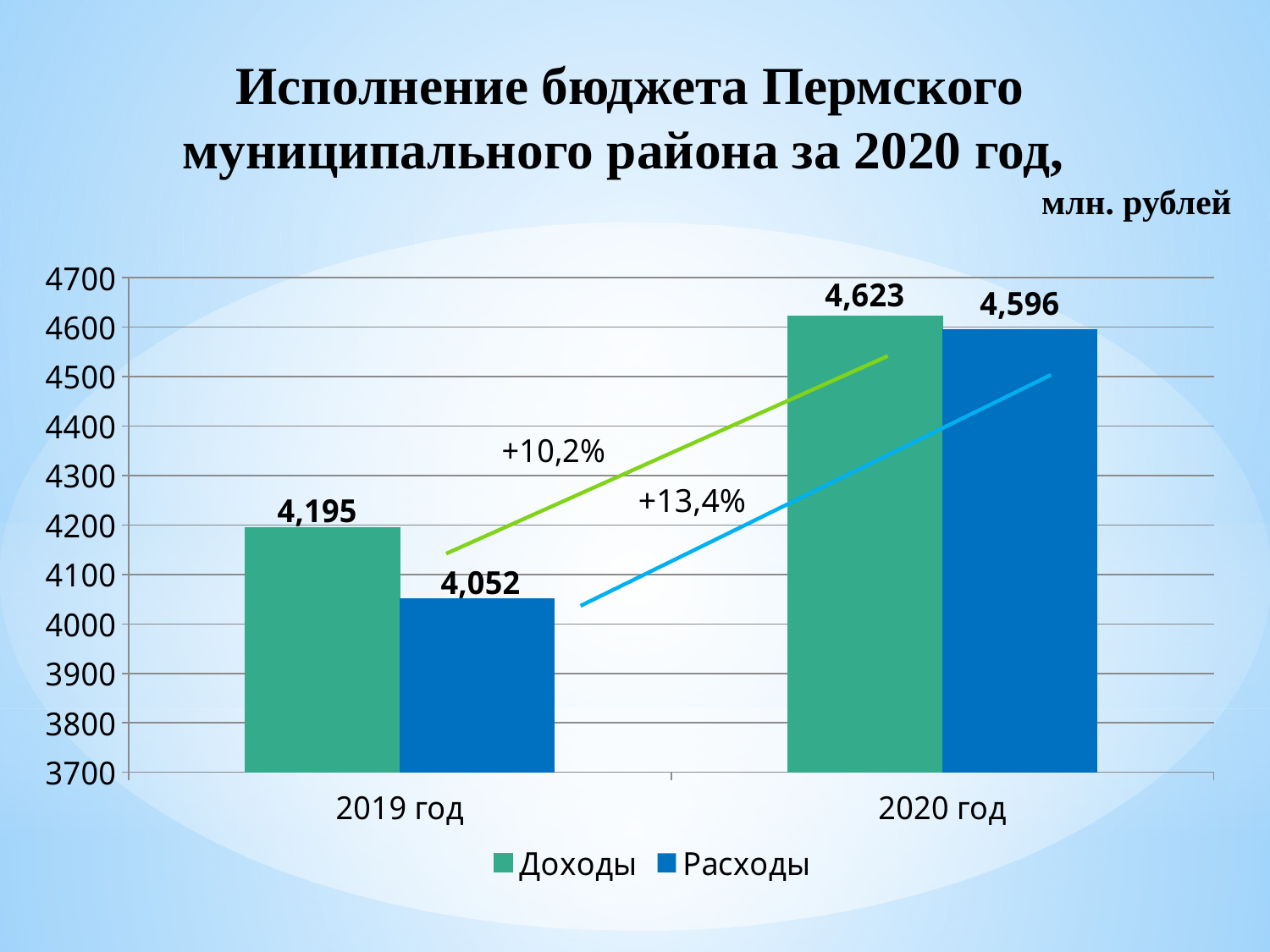
Which bar has the lowest value on the chart? Расходы, 2019 год What is the value of Расходы for 2019 год? 4,052 What is the value of Расходы for 2020 год? 4,596 Which is larger in 2019 год: Доходы or Расходы? Доходы What is the value of Доходы for 2020 год? 4,623 What is the difference between Доходы and Расходы in 2020 год? 27 Which year has the higher value for Доходы? 2020 год What kind of chart is shown on the slide? Bar chart What is the difference between Доходы and Расходы in 2019 год? 143 How many series does the legend list? 2 What is the value of Доходы for 2019 год? 4,195 What percentage growth is shown for Расходы from 2019 год to 2020 год? +13,4%